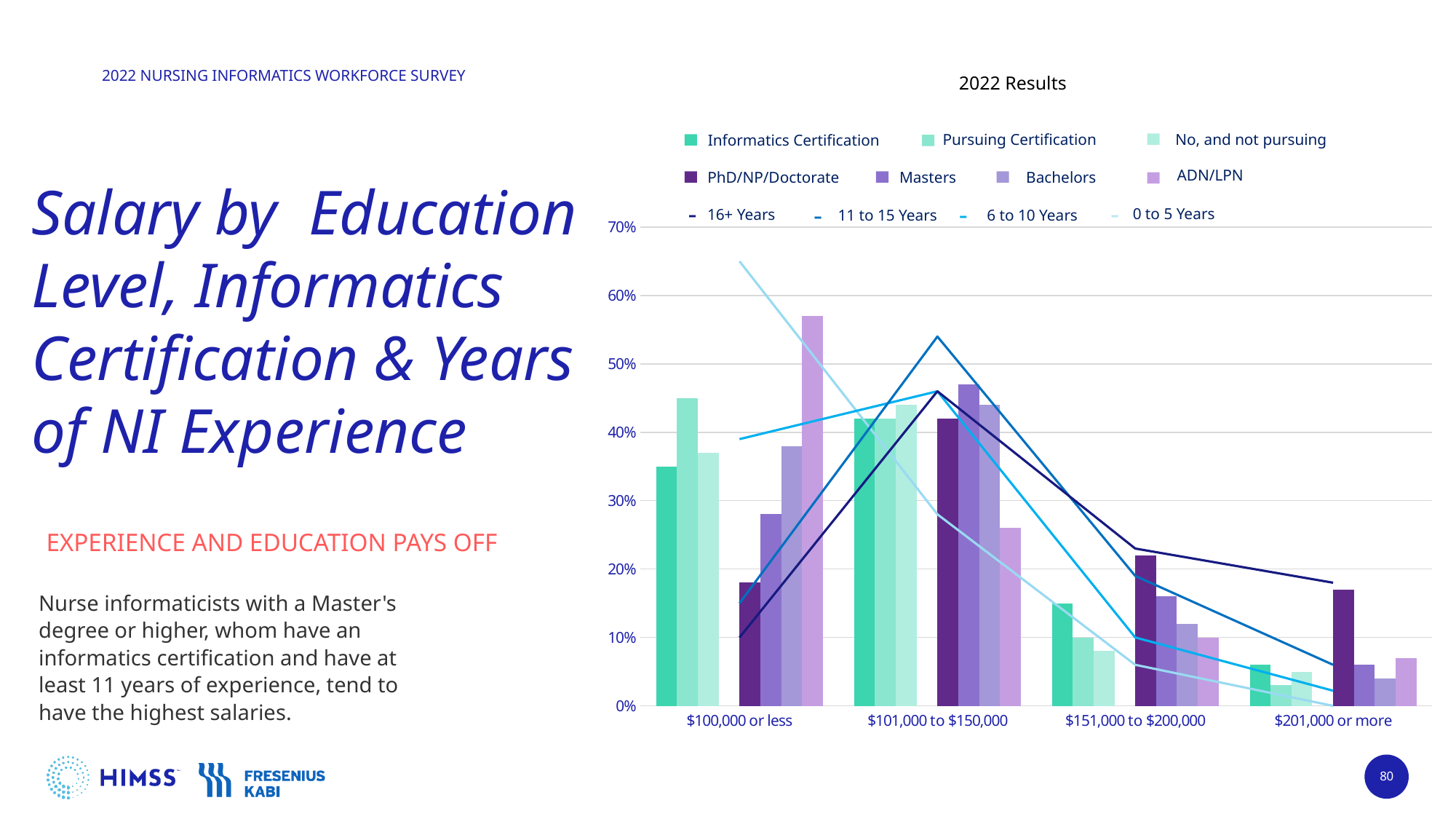
Is the 0 to 5 Years value for $100,000 or less greater or less than 60%? greater In the $151,000 to $200,000 category, which is larger: Informatics Certification or No, and not pursuing? Informatics Certification Does the 0 to 5 Years line rise or fall as salary increases along the x axis? It falls How many salary categories are shown on the x axis? 4 How many series does the legend list? 11 Which education level has the highest bar in the $201,000 or more category? PhD/NP/Doctorate Is the ADN/LPN value for $100,000 or less greater or less than 50%? greater Is the 16+ Years value for $201,000 or more greater or less than 10%? greater What is the title of the chart? 2022 Results What kind of chart is shown on the slide? A combined bar and line chart Which education level has the highest bar in the $100,000 or less category? ADN/LPN